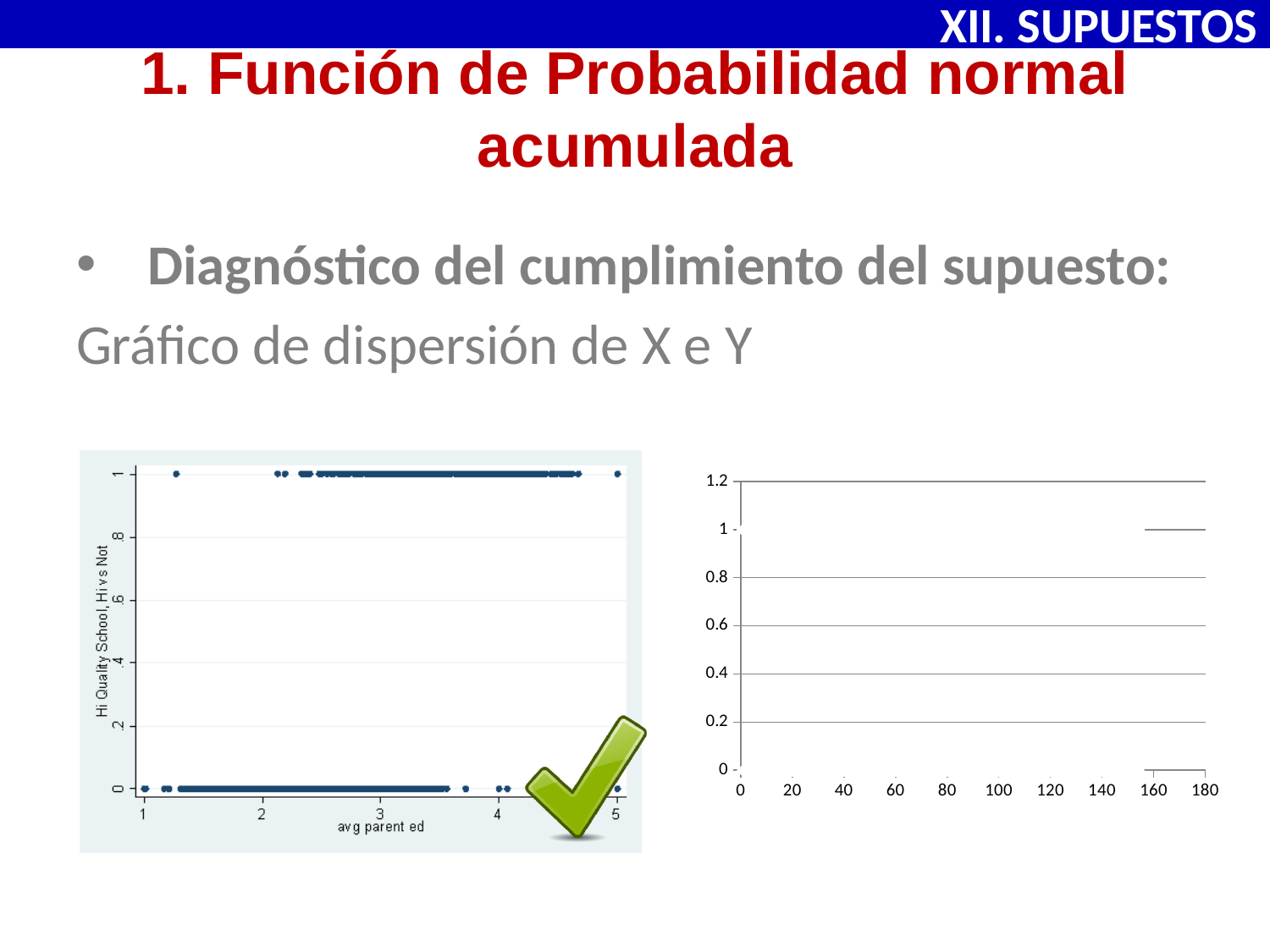
In the right chart, how many tick labels are shown on the x axis? 10 In the right chart, what is the spacing between consecutive y-axis tick labels? 0.2 In the left chart, what is the label of the y axis? Hi Quality School, Hi vs Not In the left chart, what is the lowest tick value shown on the x axis? 1 In the right chart, what is the highest tick value shown on the x axis? 180 In the right chart, what is the highest tick value shown on the y axis? 1.2 In the left chart, what is the label of the x axis? avg parent ed What kind of chart is the left chart on the slide? scatter plot In the left chart, what is the highest tick value shown on the x axis? 5 In the left chart, which two values on the y axis do all the plotted points take? 0 and 1